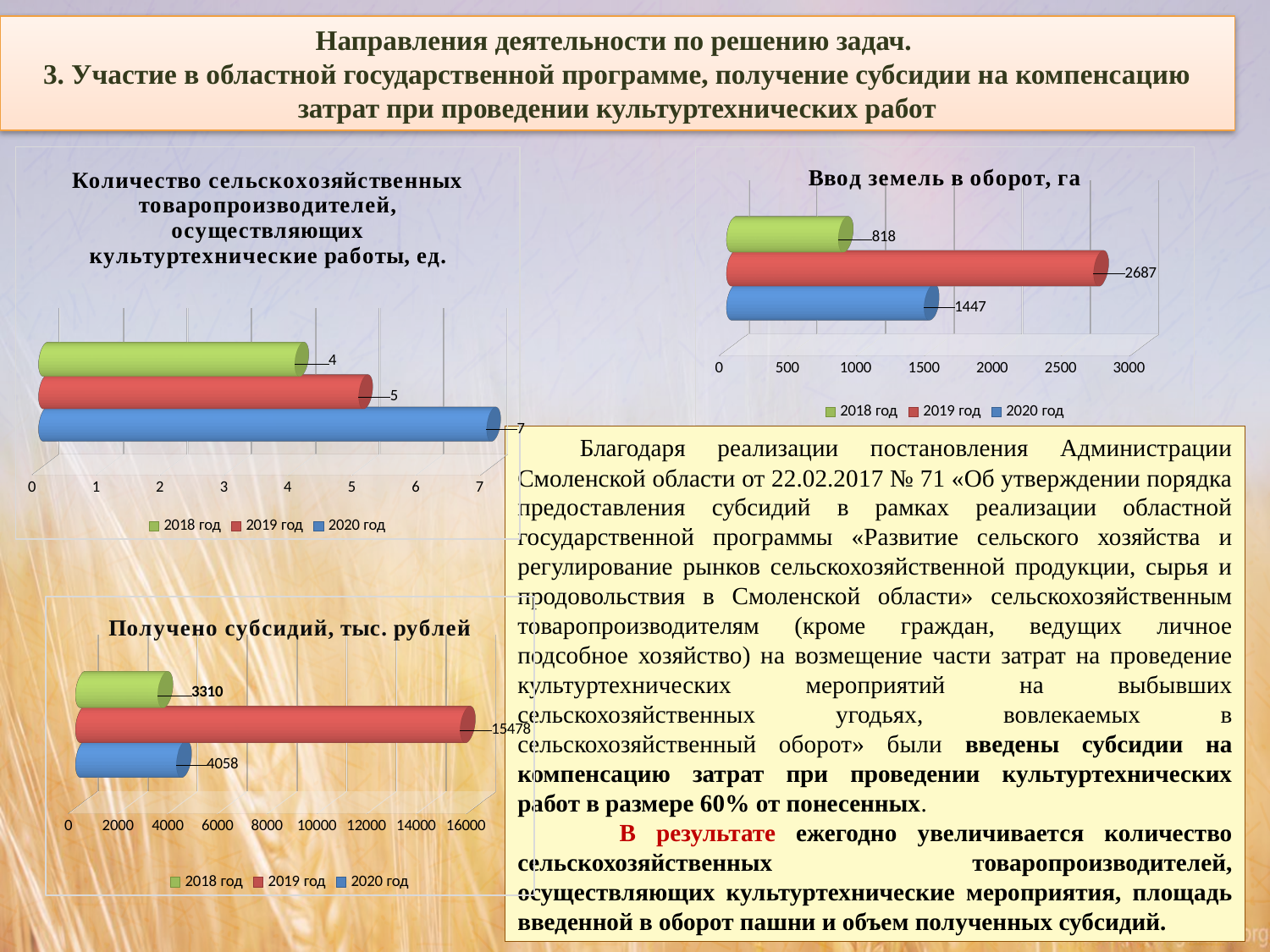
How many series does the legend of the chart 'Получено субсидий, тыс. рублей' list? 3 In the chart 'Ввод земель в оборот, га', what is the value for 2019 год? 2687 In the chart 'Получено субсидий, тыс. рублей', what is the difference between the values for 2019 год and 2020 год? 11420 In the chart 'Количество сельскохозяйственных товаропроизводителей, осуществляющих культуртехнические работы, ед.', what is the difference between the values for 2020 год and 2018 год? 3 In the chart 'Получено субсидий, тыс. рублей', what is the value for 2019 год? 15478 What type of chart is 'Ввод земель в оборот, га'? bar chart In the chart 'Ввод земель в оборот, га', which year has the highest value? 2019 год In the chart 'Получено субсидий, тыс. рублей', which is larger, the value for 2018 год or 2020 год? 2020 год In the chart 'Количество сельскохозяйственных товаропроизводителей, осуществляющих культуртехнические работы, ед.', which year has the lowest value? 2018 год In the chart 'Ввод земель в оборот, га', what is the difference between the values for 2020 год and 2018 год? 629 In the chart 'Количество сельскохозяйственных товаропроизводителей, осуществляющих культуртехнические работы, ед.', what is the value for 2020 год? 7 In the chart 'Ввод земель в оборот, га', is the value for 2020 год greater or less than 1500? less